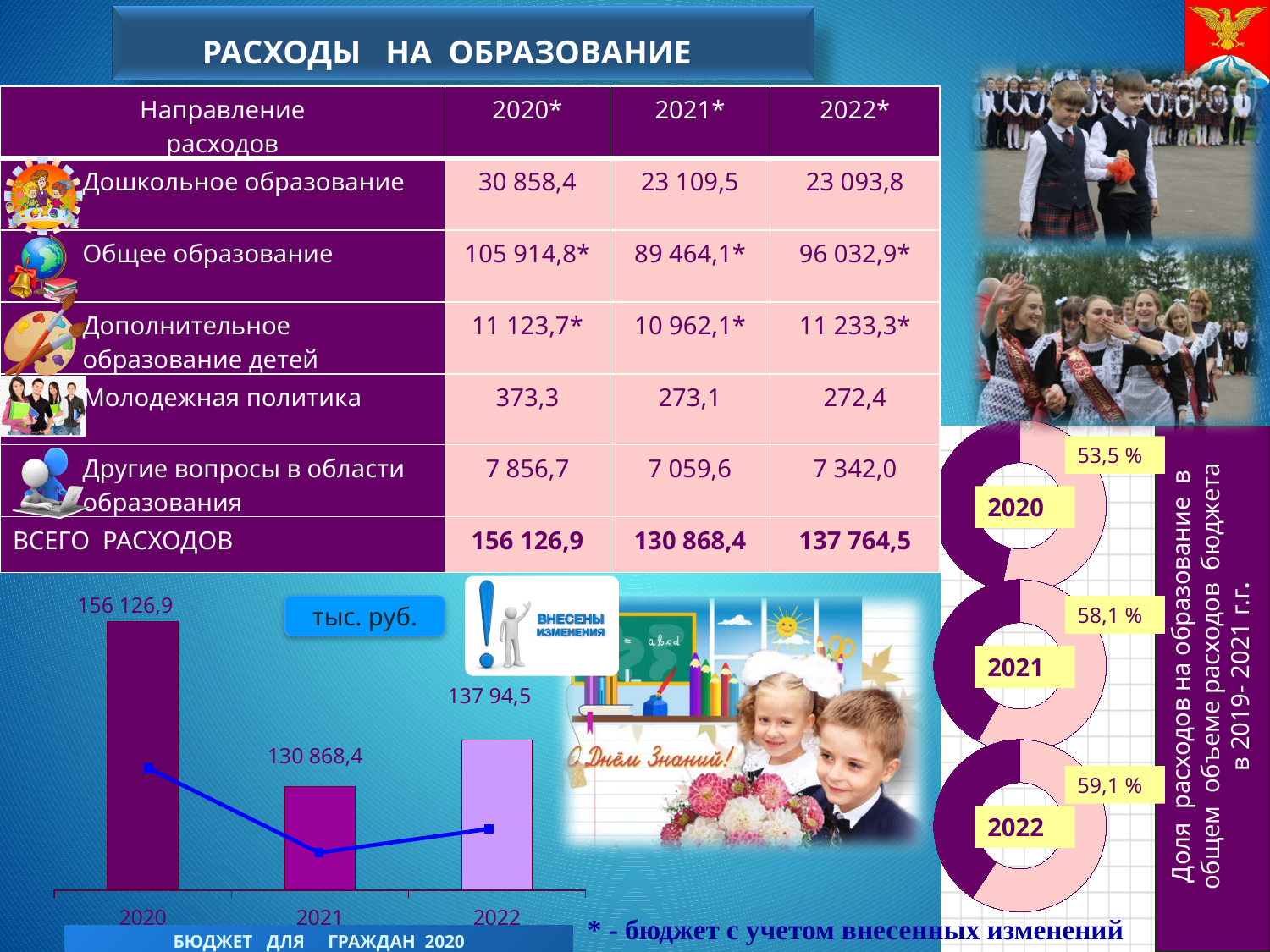
What unit is indicated in the label next to the bar chart at the bottom left? тыс. руб. In the bar chart at the bottom left, does the value rise or fall from 2020 to 2021? fall In the bar chart at the bottom left, which is larger: the value for 2020 or the value for 2022? 2020 In the bar chart at the bottom left, what is the value for 2020? 156 126,9 In the bar chart at the bottom left, which is larger: the value for 2021 or the value for 2022? 2022 What kind of chart is shown at the bottom left of the slide? bar chart How many bars are in the bar chart at the bottom left? 3 In the bar chart at the bottom left, which year has the highest value? 2020 In the bar chart at the bottom left, what is the difference between the values for 2020 and 2021? 25 258,5 In the bar chart at the bottom left, which year has the lowest value? 2021 In the ring graphics on the right of the slide, what percentage is shown for 2022? 59,1 % In the bar chart at the bottom left, what is the value for 2021? 130 868,4